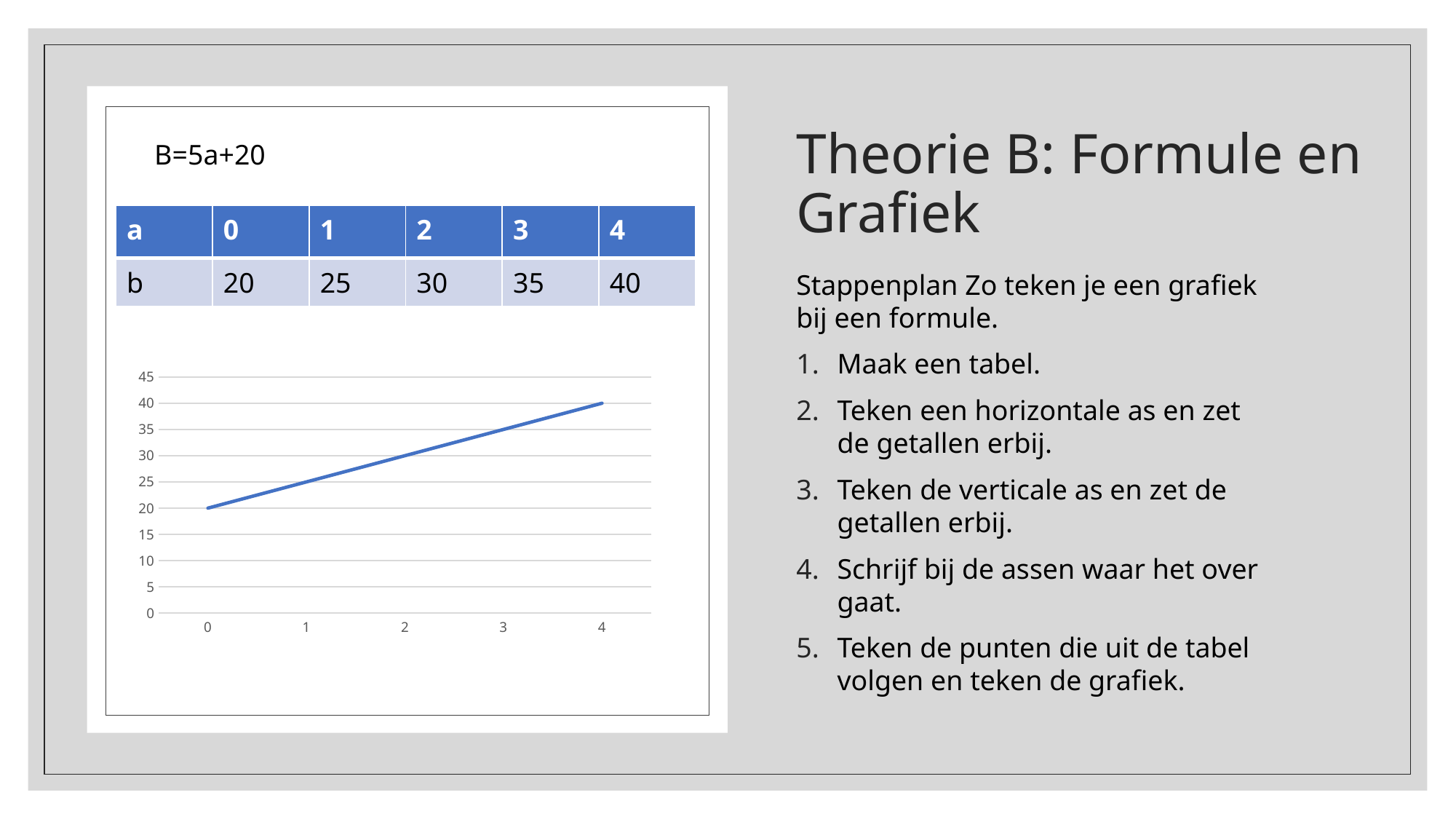
What is the value of b when a is 2 on the chart? 30 Does the line rise or fall as a increases from 0 to 4? rise Is the value at a=1 greater or less than 30? less How many points are plotted on the line? 5 At which value of a is the line highest? 4 What is the difference between the value at a=4 and the value at a=0? 20 What is the value of b when a is 0 on the chart? 20 Which is larger: the value at a=3 or the value at a=1? a=3 At which value of a is the line lowest? 0 What is the value of b when a is 4 on the chart? 40 What kind of chart is shown on the slide? line chart What formula is written above the table and chart? B=5a+20